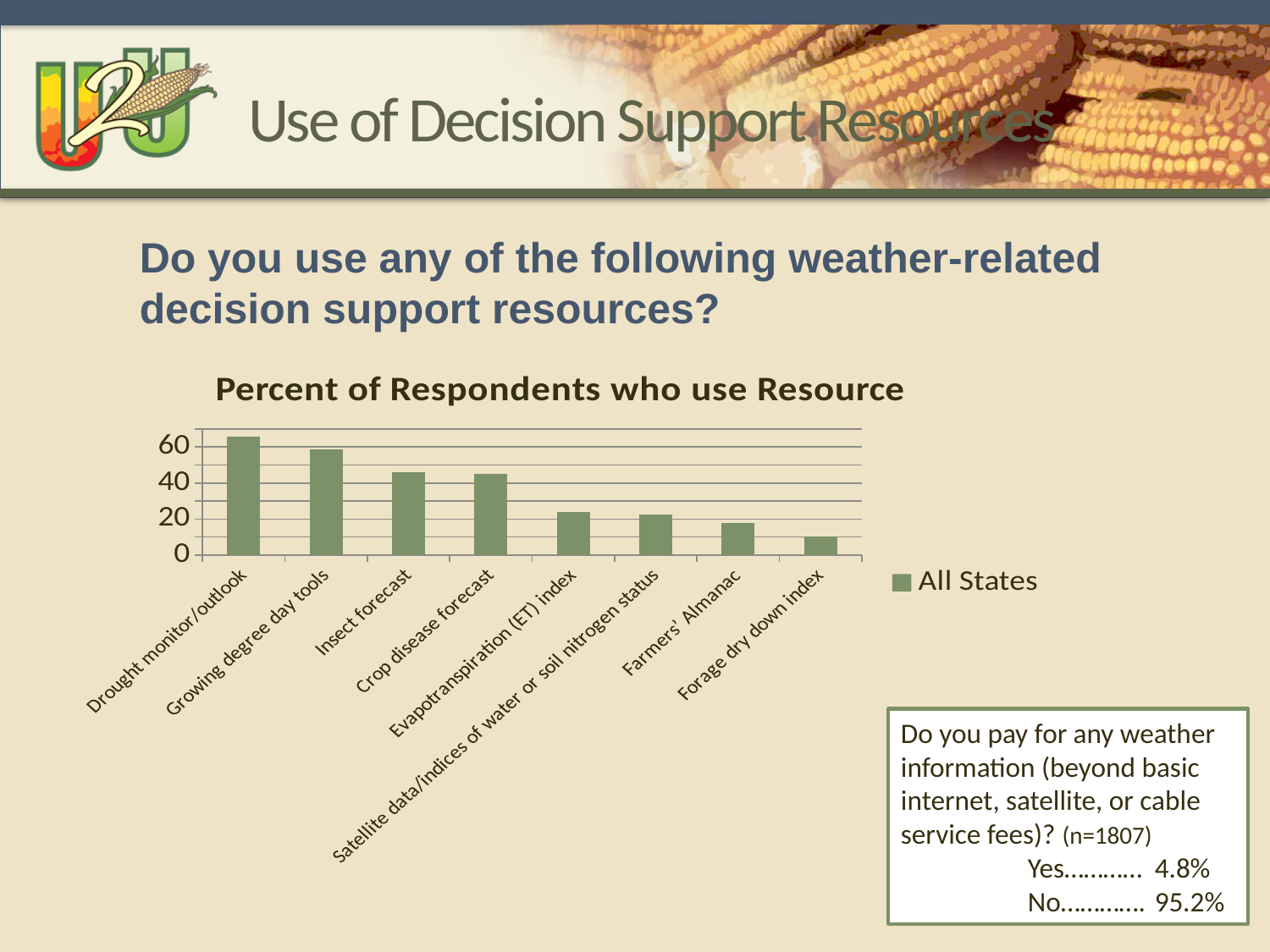
What series name appears in the chart legend? All States How many series does the chart legend list? 1 Which resource has the lowest percent of respondents using it? Forage dry down index Is the value for Farmers' Almanac greater or less than 20? less Is the value for Insect forecast greater or less than 40? greater How many resource categories are plotted in the chart? 8 Which has a larger value, Growing degree day tools or Satellite data/indices of water or soil nitrogen status? Growing degree day tools Which resource has the highest percent of respondents using it? Drought monitor/outlook Do the bar values rise or fall moving from left to right along the x axis? fall What is the title of the chart? Percent of Respondents who use Resource What kind of chart is shown on the slide? bar chart Is the value for Drought monitor/outlook greater or less than 60? greater